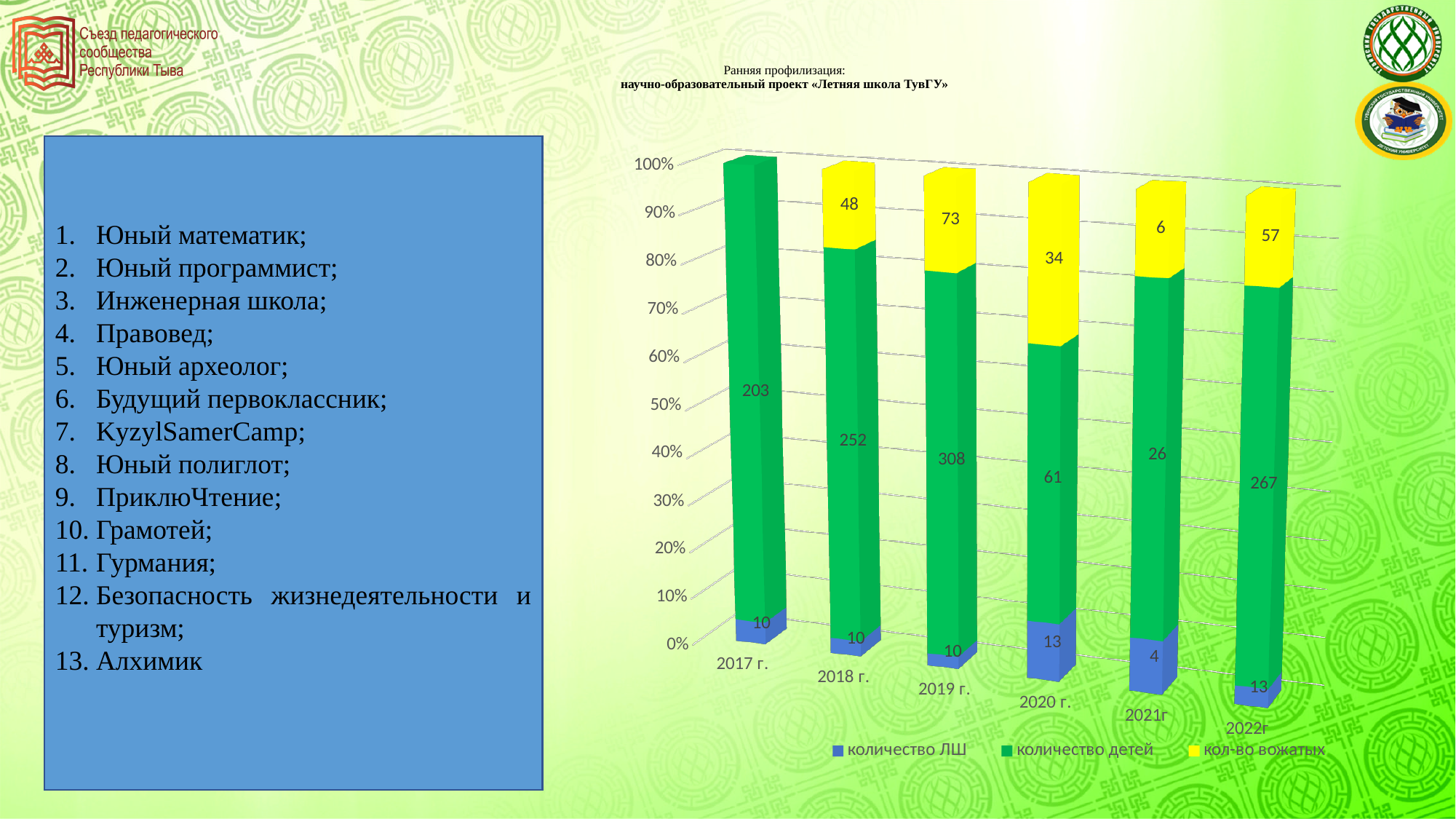
How many years are shown on the x axis of the chart? 6 In which year is количество детей the highest? 2019 г. How many series does the legend list? 3 What kind of chart is shown on the slide? Stacked bar chart What is the value of количество детей for 2019 г.? 308 What is the difference between количество детей in 2019 г. and 2018 г.? 56 What is the value of кол-во вожатых for 2022г? 57 Which is larger: кол-во вожатых in 2019 г. or in 2022г? 2019 г. In which year is количество детей the lowest? 2021г What is the value of кол-во вожатых for 2018 г.? 48 What is the total of the three labelled values in the 2020 г. bar? 108 What is the value of количество ЛШ for 2021г? 4